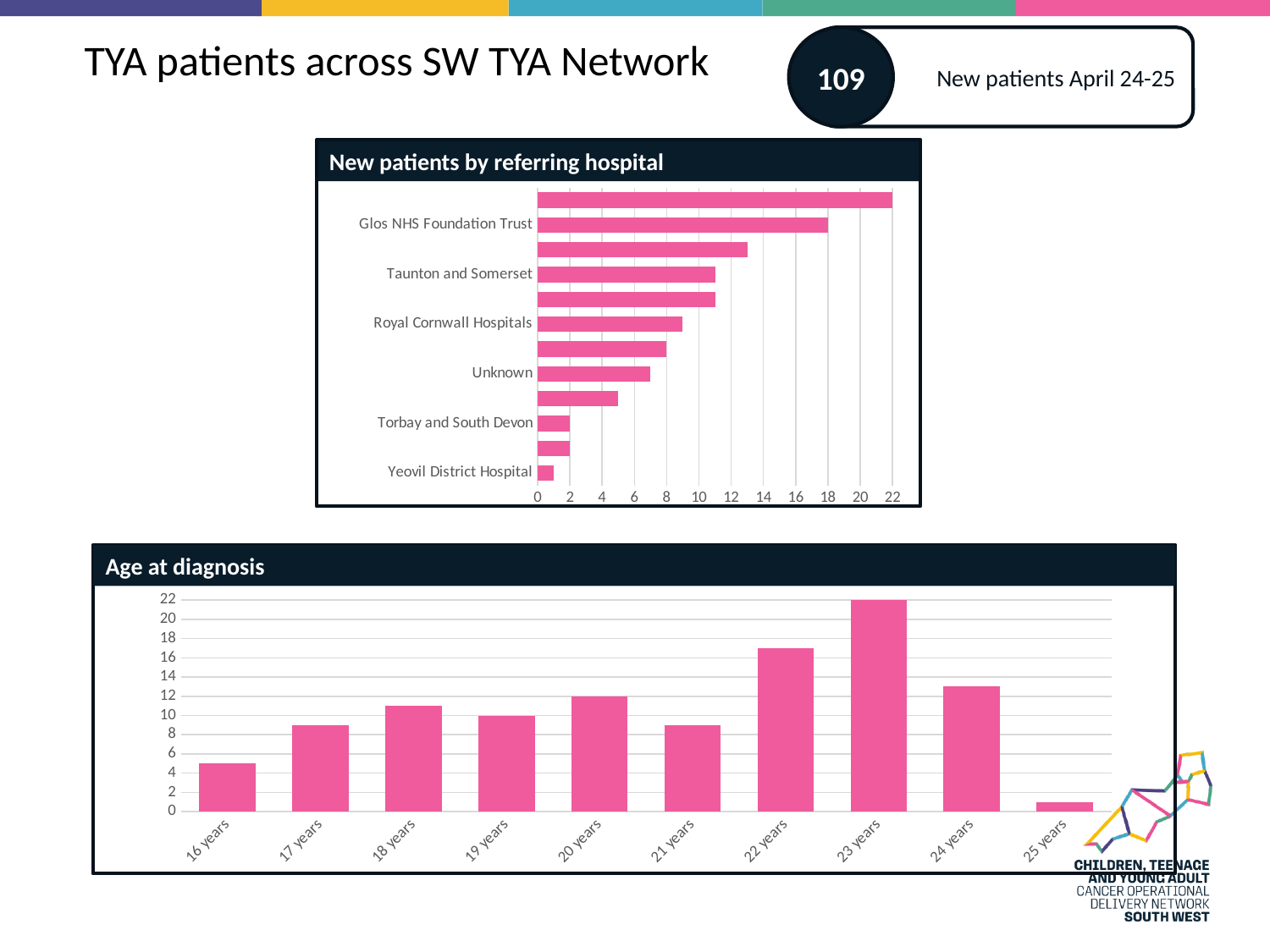
In the 'New patients by referring hospital' chart, which labelled hospital has the lowest value? Yeovil District Hospital In the 'Age at diagnosis' chart, is the value for 16 years greater or less than 6? less How many bars are plotted in the 'New patients by referring hospital' chart? 12 In the 'New patients by referring hospital' chart, is the value for Glos NHS Foundation Trust greater or less than 16? greater In the 'Age at diagnosis' chart, what is the value for 23 years? 22 In the 'New patients by referring hospital' chart, is the value for Unknown greater or less than 8? less In the 'Age at diagnosis' chart, what is the value for 20 years? 12 In the 'Age at diagnosis' chart, which age has the highest value? 23 years How many age categories are shown in the 'Age at diagnosis' chart? 10 What kind of chart is the 'New patients by referring hospital' chart? bar chart In the 'Age at diagnosis' chart, which age has the lowest value? 25 years In the 'New patients by referring hospital' chart, which has the larger value, Taunton and Somerset or Royal Cornwall Hospitals? Taunton and Somerset